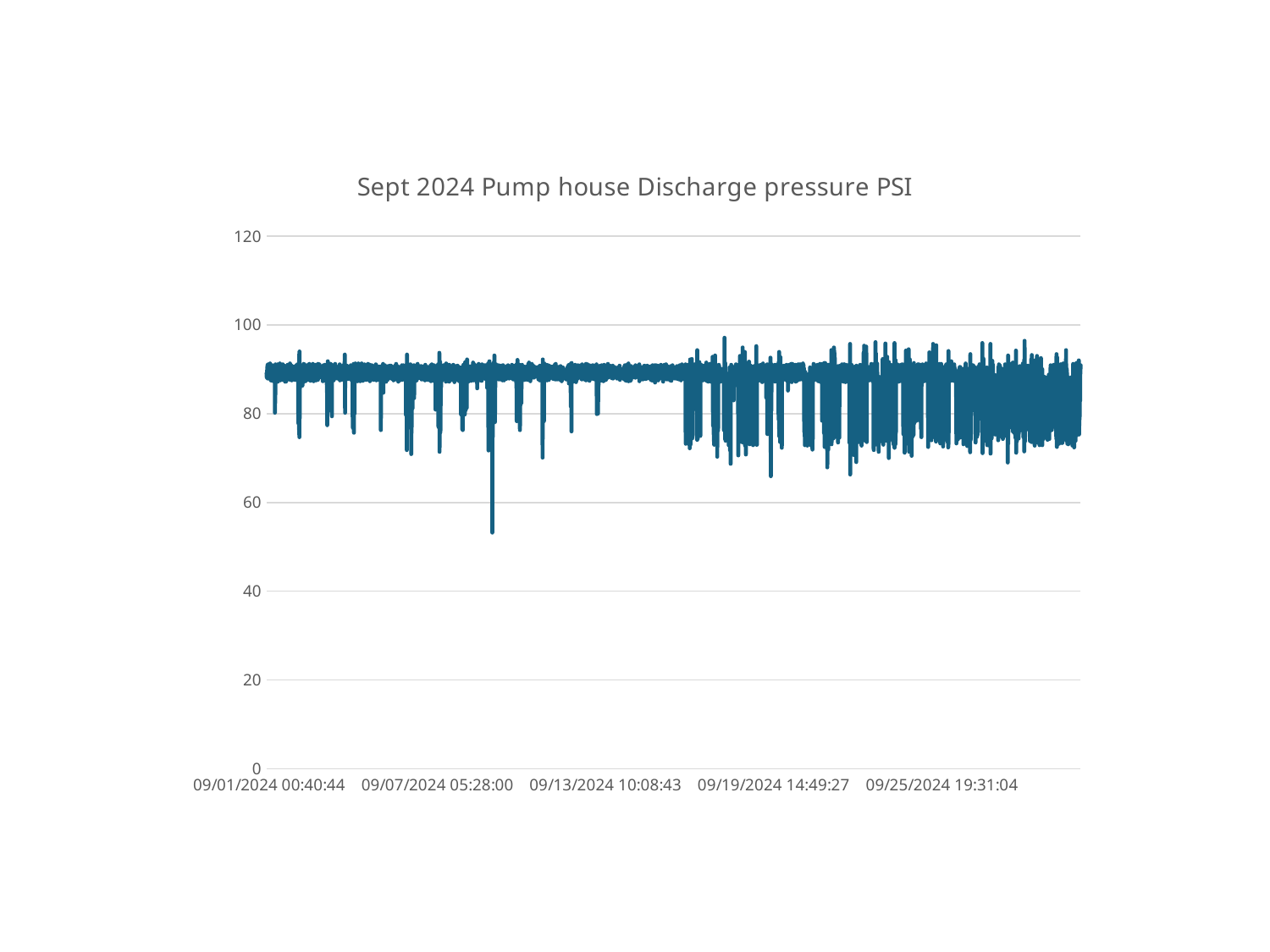
Is the variability of the line larger in the first half of the month or the second half? second half Is the highest value plotted on the chart greater or less than 100? less What is the last date label on the x axis? 09/25/2024 19:31:04 What is the highest value shown on the y axis? 120 What kind of chart is shown on the slide? Line chart Is the lowest value plotted on the chart greater or less than 40? greater What is the title of the chart? Sept 2024 Pump house Discharge pressure PSI Does the deepest dip in the series occur before or after 09/13/2024 10:08:43? before Is the lowest value plotted on the chart greater or less than 60? less What is the first date label on the x axis? 09/01/2024 00:40:44 How many date labels are shown on the x axis? 5